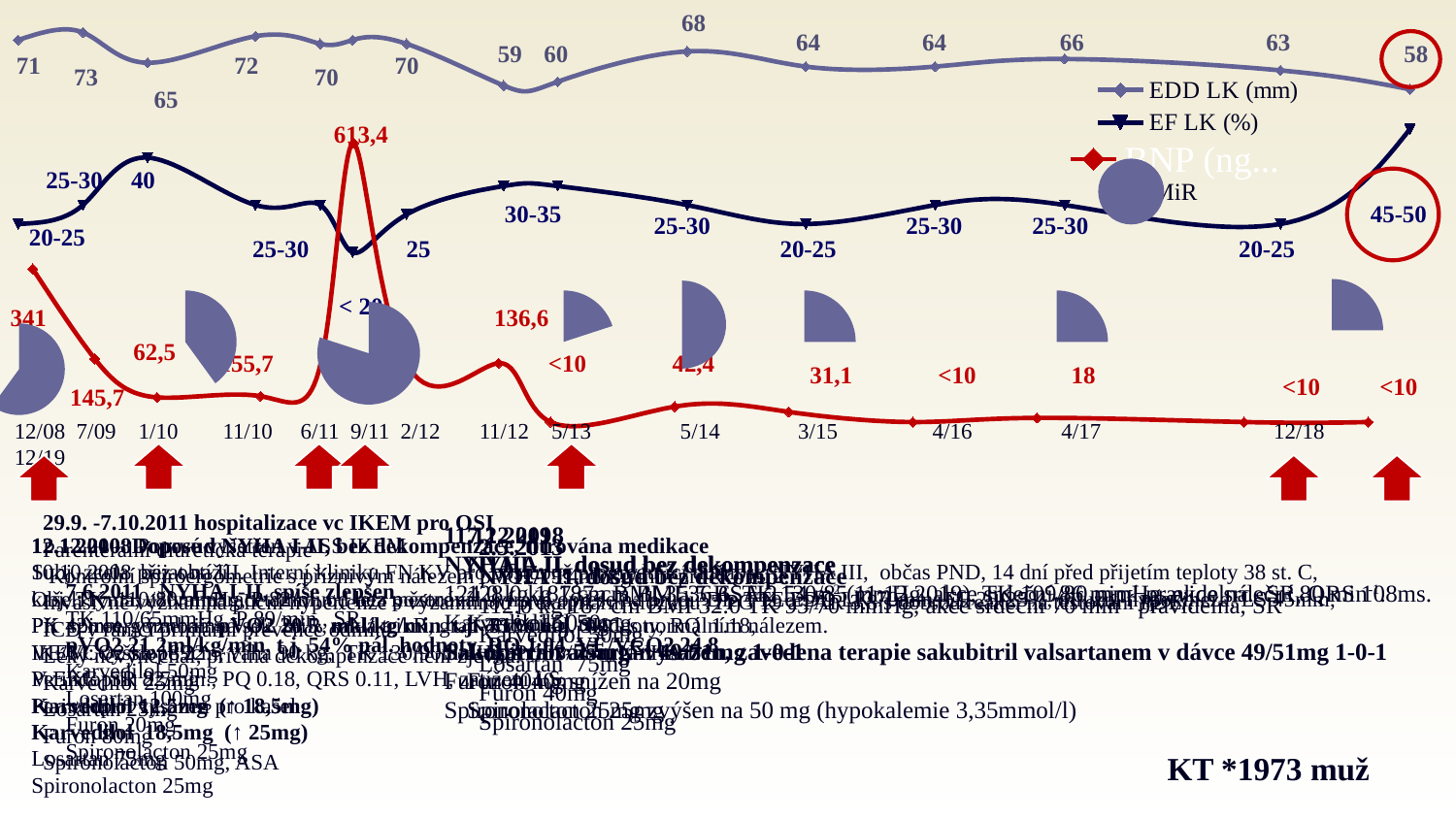
What is the last EDD LK (mm) value shown, circled at the right end of the chart? 58 Does the EDD LK (mm) series overall rise or fall from the left of the chart to the right? fall What is the highest EDD LK (mm) value labelled on the chart? 73 What is the difference between the highest and lowest labelled EDD LK (mm) values? 15 What is the first EDD LK (mm) value shown at the left of the chart (12/08)? 71 What is the peak BNP value labelled on the chart? 613,4 Which legend entry is shown with the diamond markers? EDD LK (mm) What is the BNP value labelled at the start of the chart (12/08)? 341 What is the lowest EDD LK (mm) value labelled on the chart? 58 What is the last EF LK (%) value shown, circled at the right end of the chart? 45-50 Which is larger, the BNP value of 341 at 12/08 or the BNP value of 145,7 at 7/09? 341 What kind of chart is shown on the slide? line chart